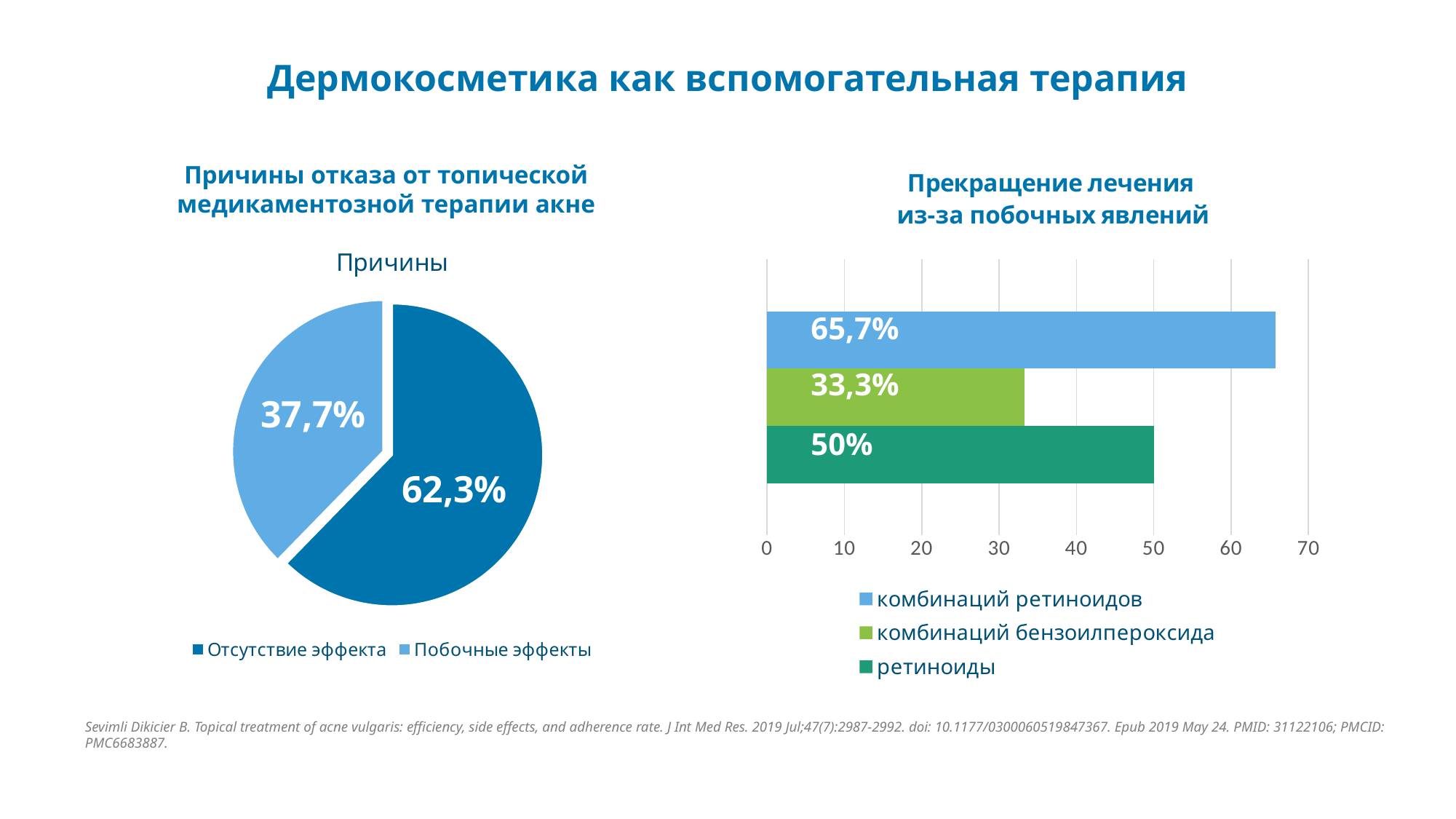
На диаграмме «Прекращение лечения из-за побочных явлений» что больше: значение для «ретиноиды» или для «комбинаций бензоилпероксида»? ретиноиды На диаграмме «Прекращение лечения из-за побочных явлений» какое значение у «ретиноиды»? 50% На диаграмме «Прекращение лечения из-за побочных явлений» у какой категории наименьшее значение? комбинаций бензоилпероксида На круговой диаграмме «Причины» какая доля приходится на «Отсутствие эффекта»? 62,3% На диаграмме «Прекращение лечения из-за побочных явлений» какое значение у «комбинаций ретиноидов»? 65,7% На круговой диаграмме «Причины» какая доля приходится на «Побочные эффекты»? 37,7% На диаграмме «Прекращение лечения из-за побочных явлений» на сколько процентных пунктов значение «комбинаций ретиноидов» больше значения «ретиноиды»? 15,7 На круговой диаграмме «Причины» какая категория занимает наибольшую долю? Отсутствие эффекта На круговой диаграмме «Причины» на сколько процентных пунктов доля «Отсутствие эффекта» больше доли «Побочные эффекты»? 24,6 Сколько элементов перечислено в легенде диаграммы «Прекращение лечения из-за побочных явлений»? 3 Какого типа диаграмма слева под заголовком «Причины»? Круговая диаграмма На диаграмме «Прекращение лечения из-за побочных явлений» какое значение у «комбинаций бензоилпероксида»? 33,3%